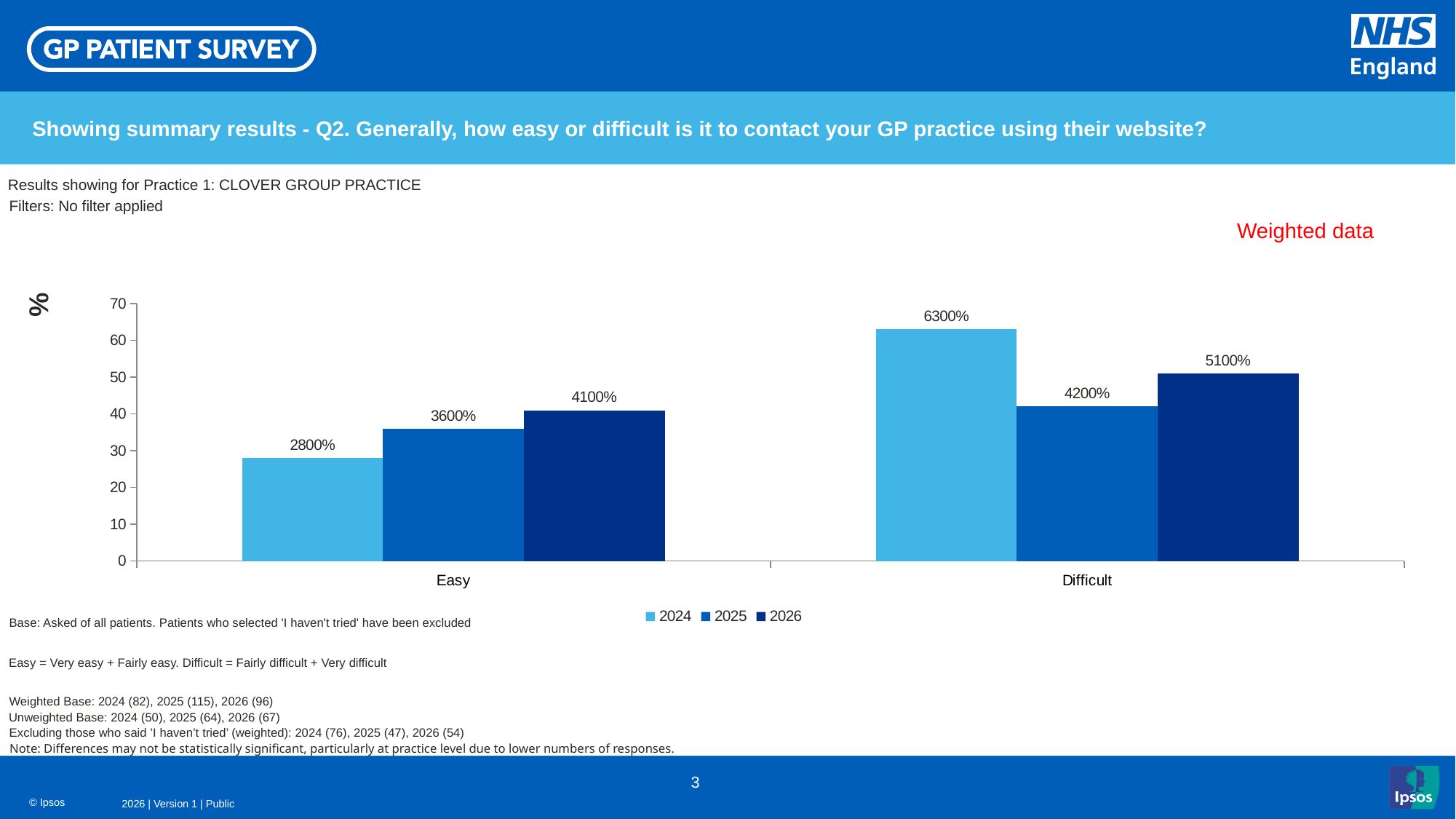
Do the values in the Easy category rise or fall from 2024 to 2026? rise In the Difficult category, which is larger: the 2025 value or the 2026 value? 2026 What is the value for 2025 in the Difficult category? 4200% Which year has the lowest value in the Easy category? 2024 What is the value for 2024 in the Easy category? 2800% How many series does the legend list? 3 How many categories are shown on the x axis? 2 What kind of chart is shown on the slide? bar chart What is the difference between the 2026 and 2024 values in the Easy category? 1300% What is the value for 2024 in the Difficult category? 6300% Which year has the highest value in the Difficult category? 2024 What is the value for 2026 in the Easy category? 4100%